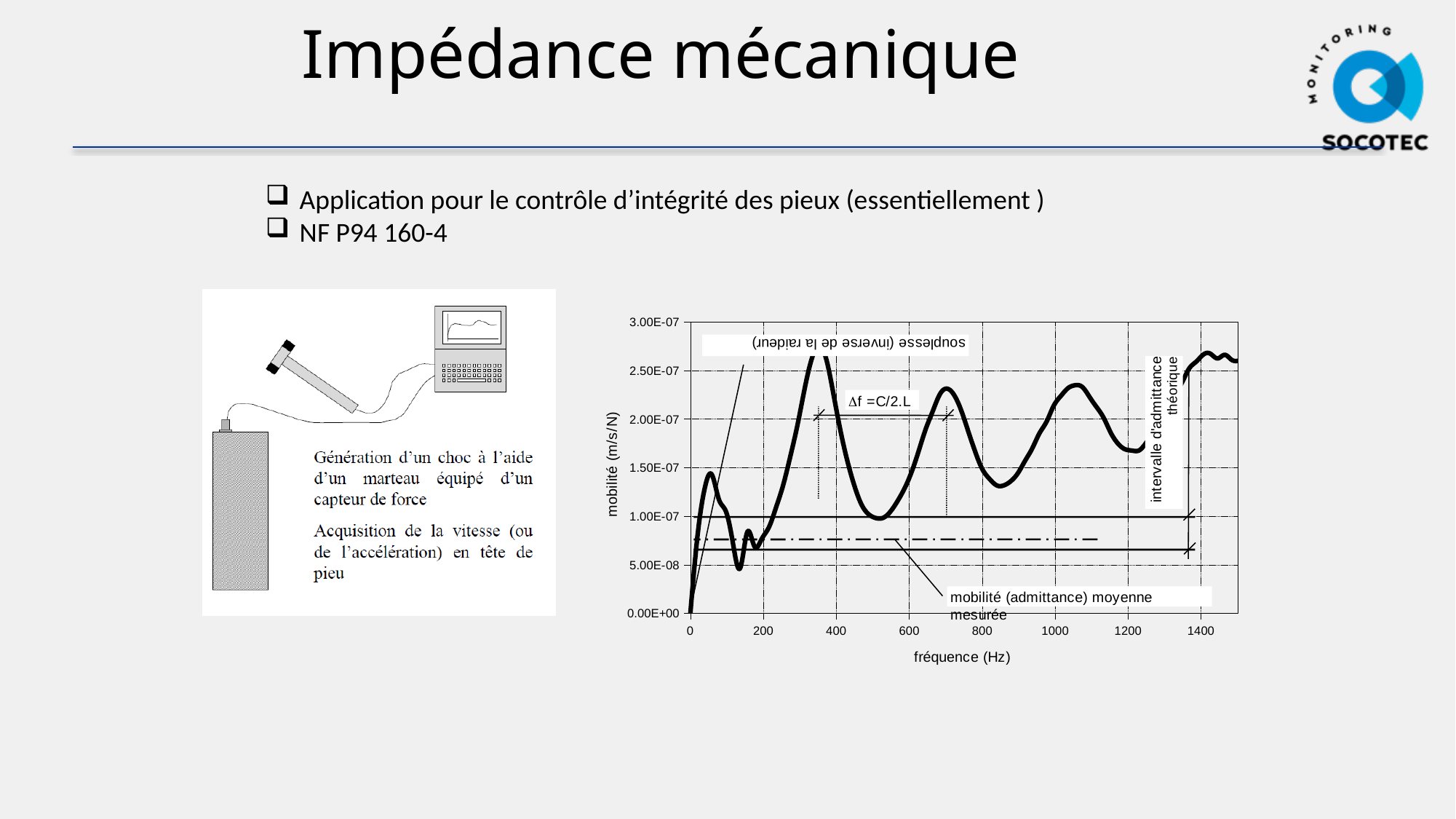
What kind of chart is shown on the right of the slide? line chart What is the label of the x axis of the chart? fréquence (Hz) Is the mobility value at 1000 Hz greater or less than 2.00E-07? greater Does the mobility curve rise or fall between 550 Hz and 700 Hz? rise How many tick labels are shown on the x axis of the chart? 8 What is the highest tick value shown on the x axis of the chart? 1400 Does the mobility curve rise or fall between 400 Hz and 500 Hz? fall What is the highest value shown on the y axis of the chart? 3.00E-07 Is the mobility value at 700 Hz greater or less than 2.00E-07? greater Is the mobility value at 350 Hz greater or less than 2.50E-07? greater What is the label of the y axis of the chart? mobilité (m/s/N)